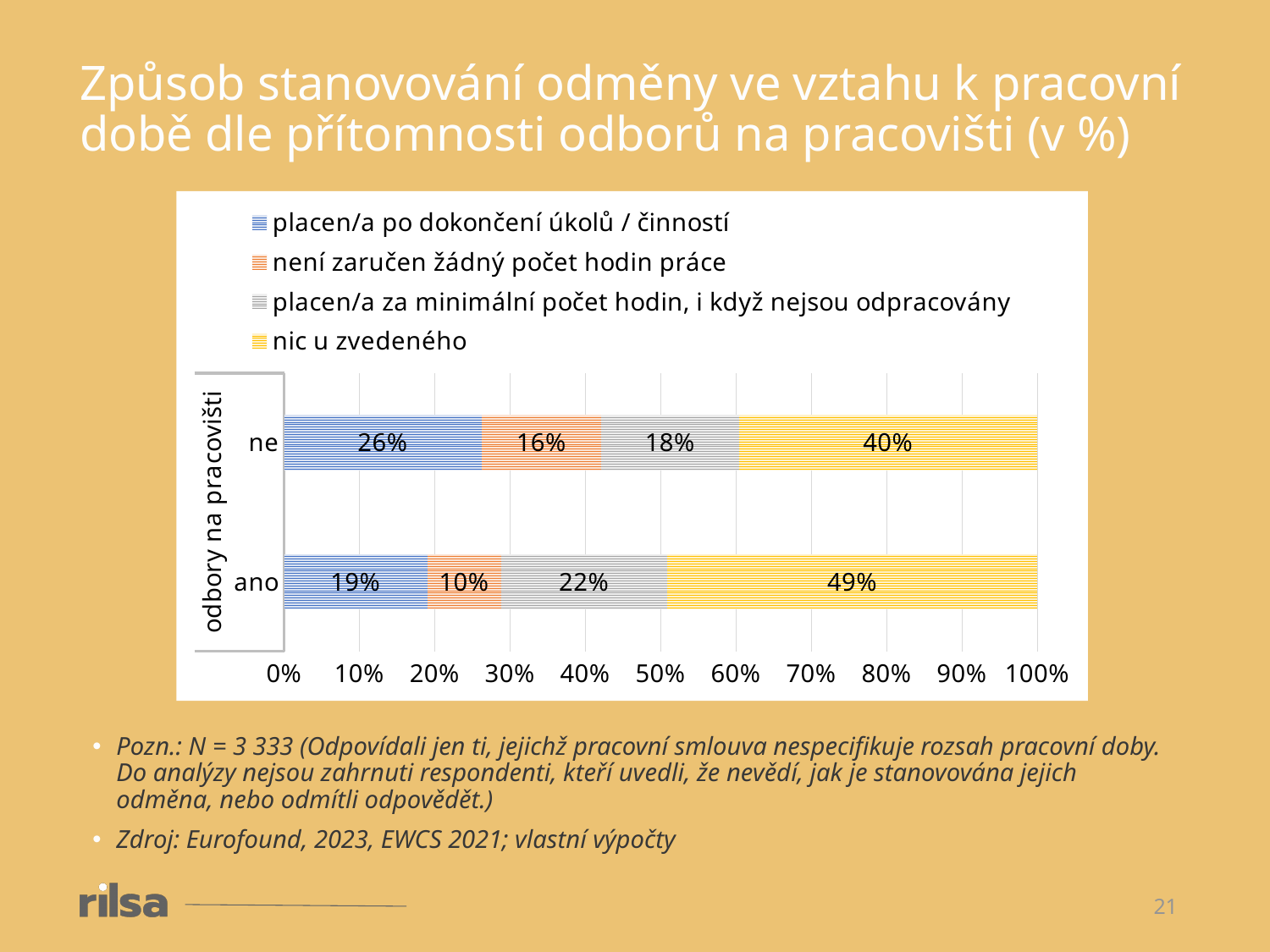
What is the value for 'placen/a za minimální počet hodin, i když nejsou odpracovány' in the 'ne' category? 18% Which series has the largest share in the 'ano' bar? nic u zvedeného What is the value for 'není zaručen žádný počet hodin práce' in the 'ano' category? 10% What kind of chart is shown on the slide? stacked bar chart What is the total of the 'ne' stacked bar? 100% How many categories are shown on the vertical axis? 2 Which category has the larger value for 'placen/a za minimální počet hodin, i když nejsou odpracovány', 'ne' or 'ano'? ano How many series does the legend list? 4 What is the value for 'placen/a po dokončení úkolů / činností' in the 'ne' category? 26% What is the difference between the 'nic u zvedeného' values for 'ano' and 'ne'? 9% What is the value for 'nic u zvedeného' in the 'ano' category? 49% Which series has the smallest share in the 'ne' bar? není zaručen žádný počet hodin práce